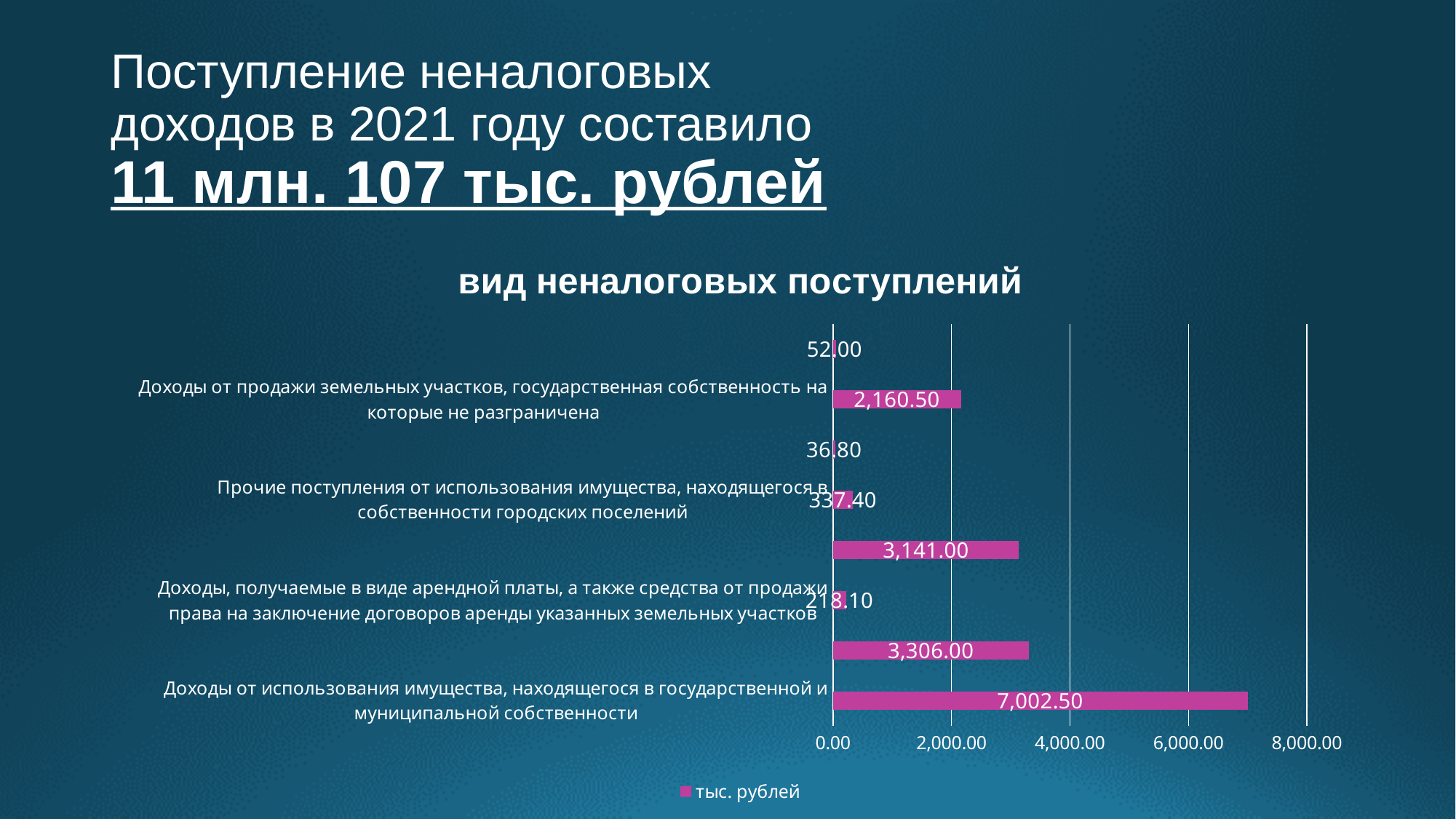
What is the smallest data label value shown in the chart? 36.80 What is the value for 'Доходы от использования имущества, находящегося в государственной и муниципальной собственности'? 7,002.50 What is the title of the chart? вид неналоговых поступлений What is the value for 'Доходы от продажи земельных участков, государственная собственность на которые не разграничена'? 2,160.50 What is the difference between the value for 'Доходы от использования имущества, находящегося в государственной и муниципальной собственности' and the value for 'Доходы от продажи земельных участков, государственная собственность на которые не разграничена'? 4,842.00 How many bars are plotted in the chart? 8 What is the value for 'Прочие поступления от использования имущества, находящегося в собственности городских поселений'? 337.40 How many series does the legend list? 1 Which category has the highest value in the chart? Доходы от использования имущества, находящегося в государственной и муниципальной собственности Which is larger: the value for 'Прочие поступления от использования имущества, находящегося в собственности городских поселений' or the value for 'Доходы, получаемые в виде арендной платы, а также средства от продажи права на заключение договоров аренды указанных земельных участков'? Прочие поступления от использования имущества, находящегося в собственности городских поселений What is the value for 'Доходы, получаемые в виде арендной платы, а также средства от продажи права на заключение договоров аренды указанных земельных участков'? 218.10 What type of chart is shown on the slide? bar chart